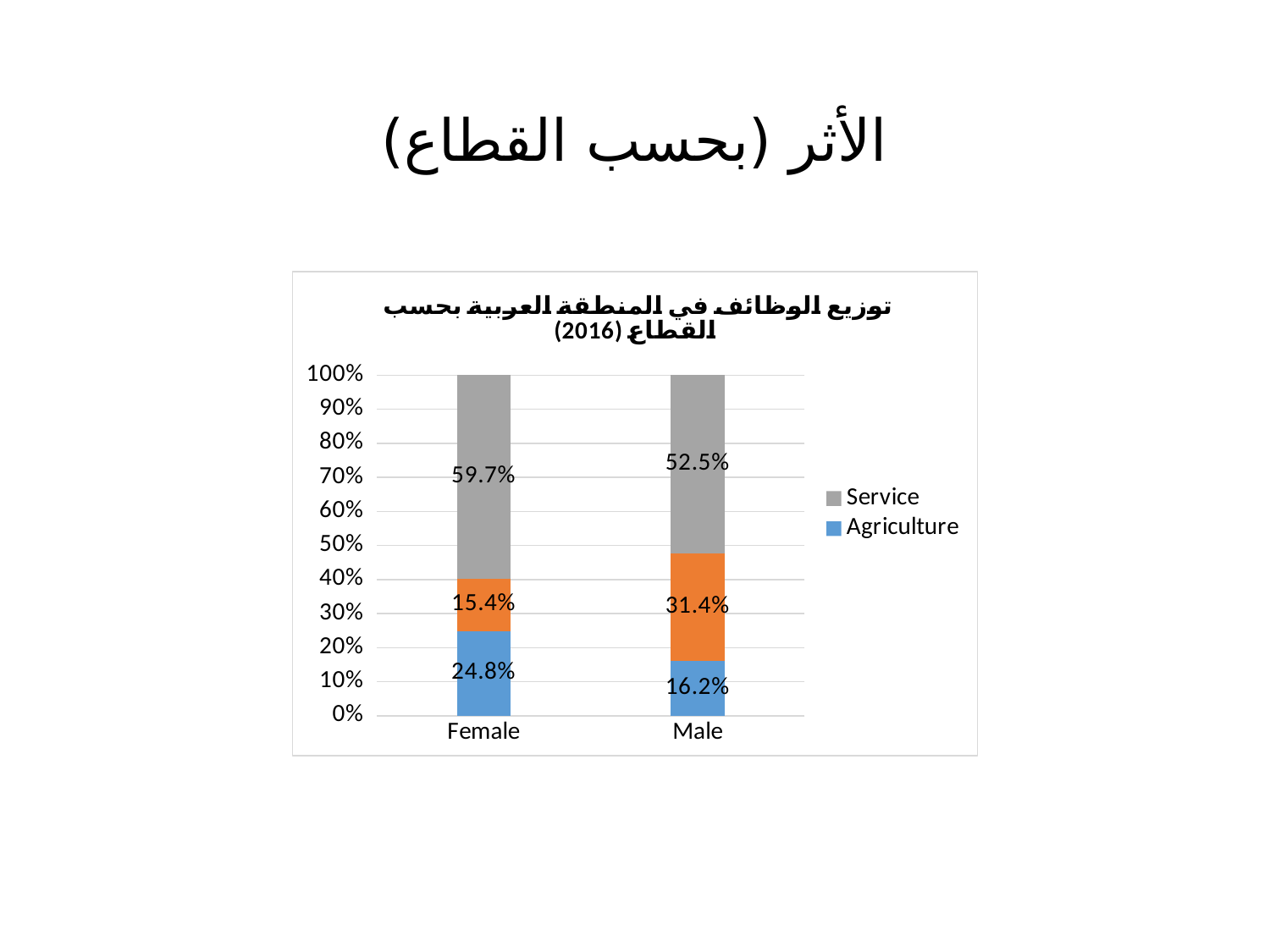
What is the Agriculture value for Female? 24.8% How many categories are shown on the x axis? 2 Which category has the higher Agriculture value, Female or Male? Female Which category has the higher Service value, Female or Male? Female What is the Agriculture value for Male? 16.2% What is the difference between the Agriculture values for Female and Male? 8.6 percentage points What is the Service value for Female? 59.7% How many series does the legend list? 2 What is the Service value for Male? 52.5% What is the difference between the Service values for Female and Male? 7.2 percentage points What colour represents Service in the legend? Gray What kind of chart is shown on the slide? Stacked bar chart